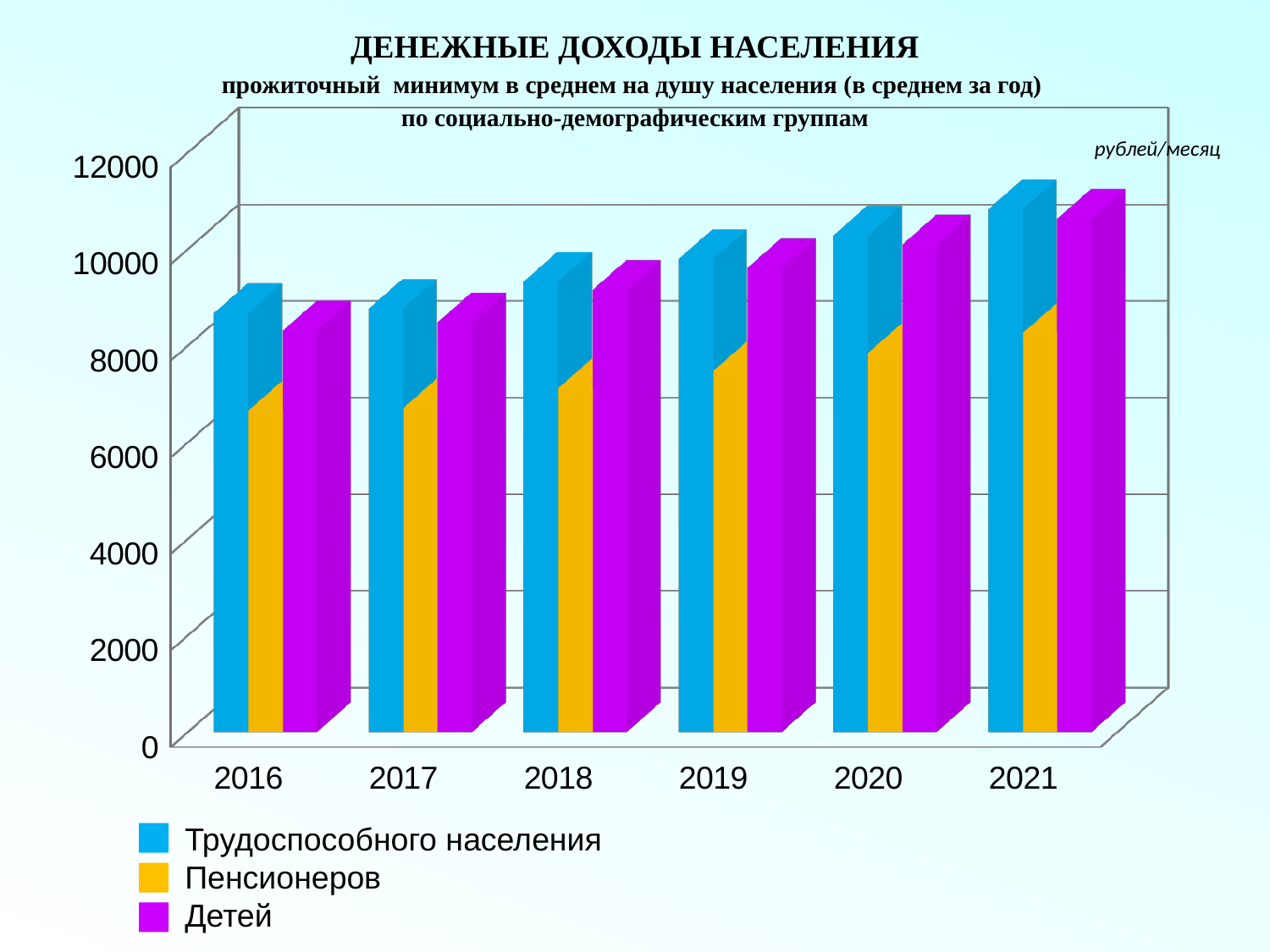
Which year has the lowest value for Пенсионеров? 2016 Is the value for Трудоспособного населения in 2021 greater or less than 10000? greater In 2018, which is larger: the value for Трудоспособного населения or for Пенсионеров? Трудоспособного населения Is the value for Трудоспособного населения in 2016 greater or less than 10000? less Is the value for Детей in 2019 greater or less than 8000? greater What unit is indicated in the top right corner of the chart? рублей/месяц How many years are shown on the x axis of the chart? 6 Which year has the highest value for Трудоспособного населения? 2021 Do the values for Детей rise or fall from 2016 to 2021? rise What kind of chart is shown on the slide? bar chart How many series does the legend list? 3